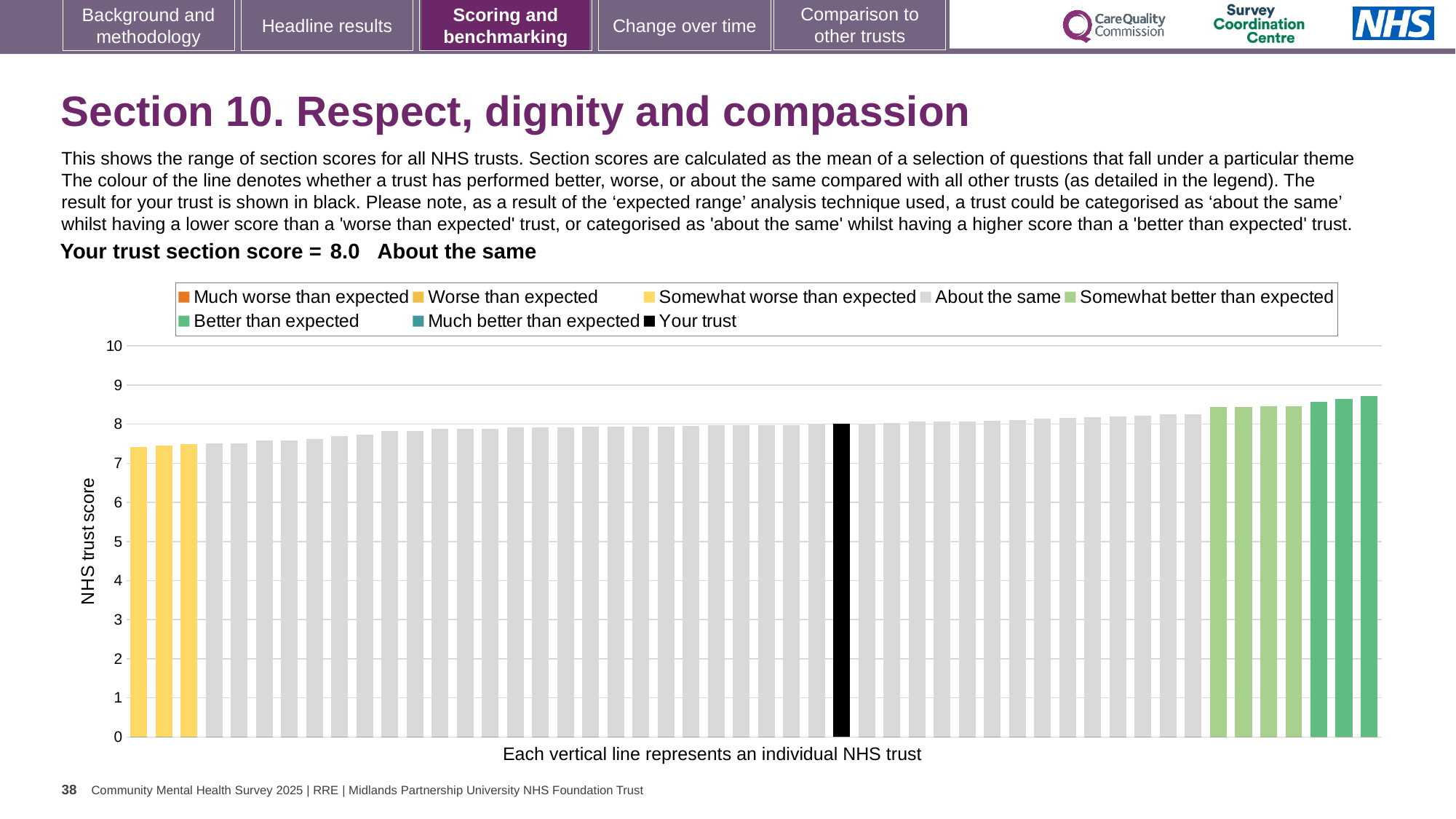
Is the value of the highest bar on the chart greater or less than 8? greater What is the highest value shown on the vertical axis? 10 Do the bar values rise or fall from left to right across the chart? rise What colour is the bar representing your trust? black What is the label on the vertical axis of the chart? NHS trust score Is the value of the lowest bar on the chart greater or less than 8? less Is the value of the black bar (your trust) greater or less than 7? greater What is your trust's section score for Section 10, Respect, dignity and compassion? 8.0 What kind of chart is shown on the slide? bar chart How is your trust categorised compared with other trusts in this section? About the same How many entries does the chart legend list? 8